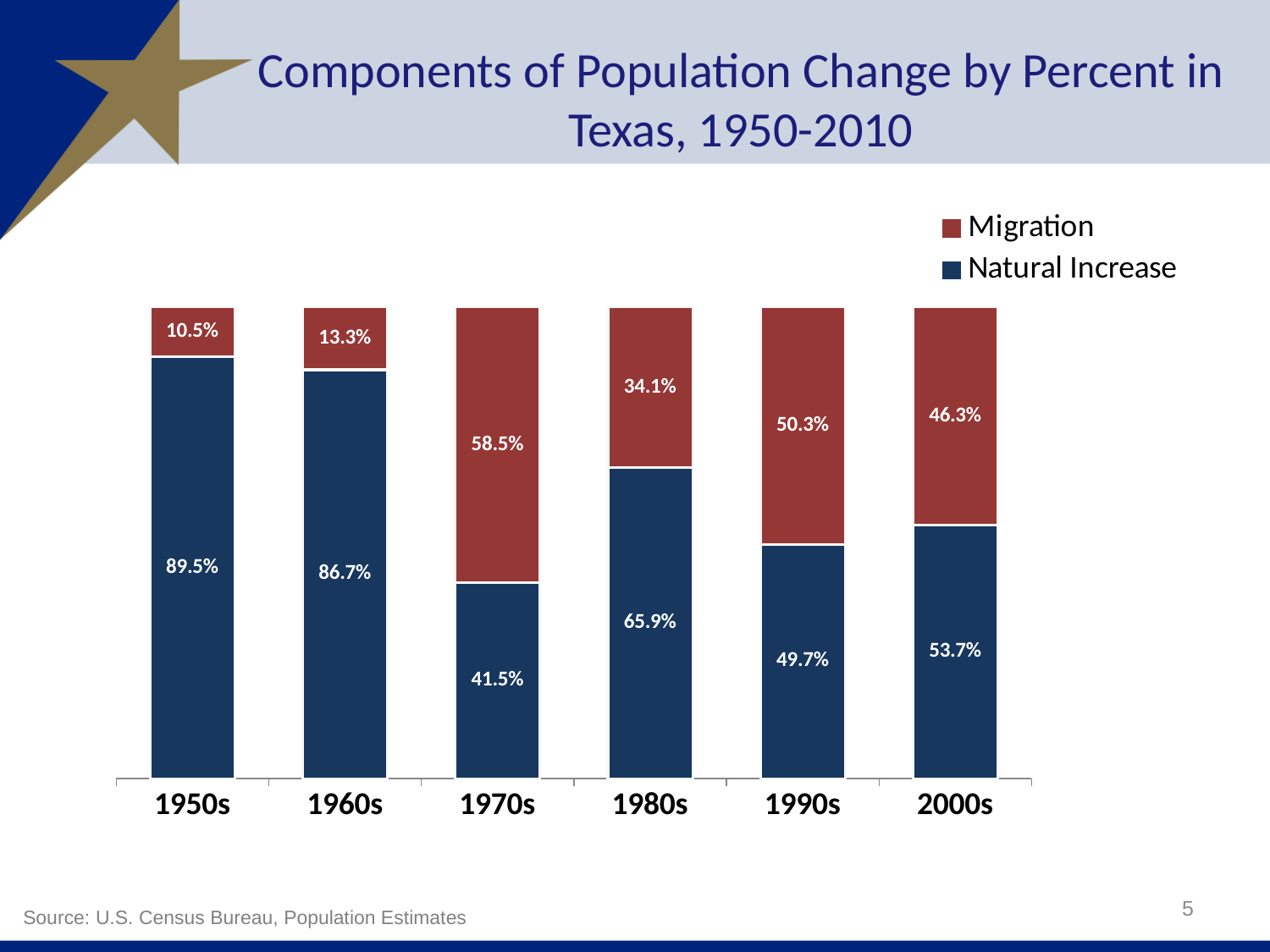
What is the Natural Increase value for the 1950s? 89.5% Which decade has the lowest Natural Increase value? 1970s How many series does the legend list? 2 What is the Migration value for the 1970s? 58.5% What is the Natural Increase value for the 2000s? 53.7% Which colour represents Migration in the legend? Red Which decade has the highest Migration value? 1970s How many decades are shown on the x axis? 6 What is the total of the stacked bar for the 1990s? 100% Which is larger, the Migration value for the 1980s or the Migration value for the 2000s? 2000s What kind of chart is shown on the slide? Stacked bar chart What is the difference between the Natural Increase values for the 1950s and the 1960s? 2.8%